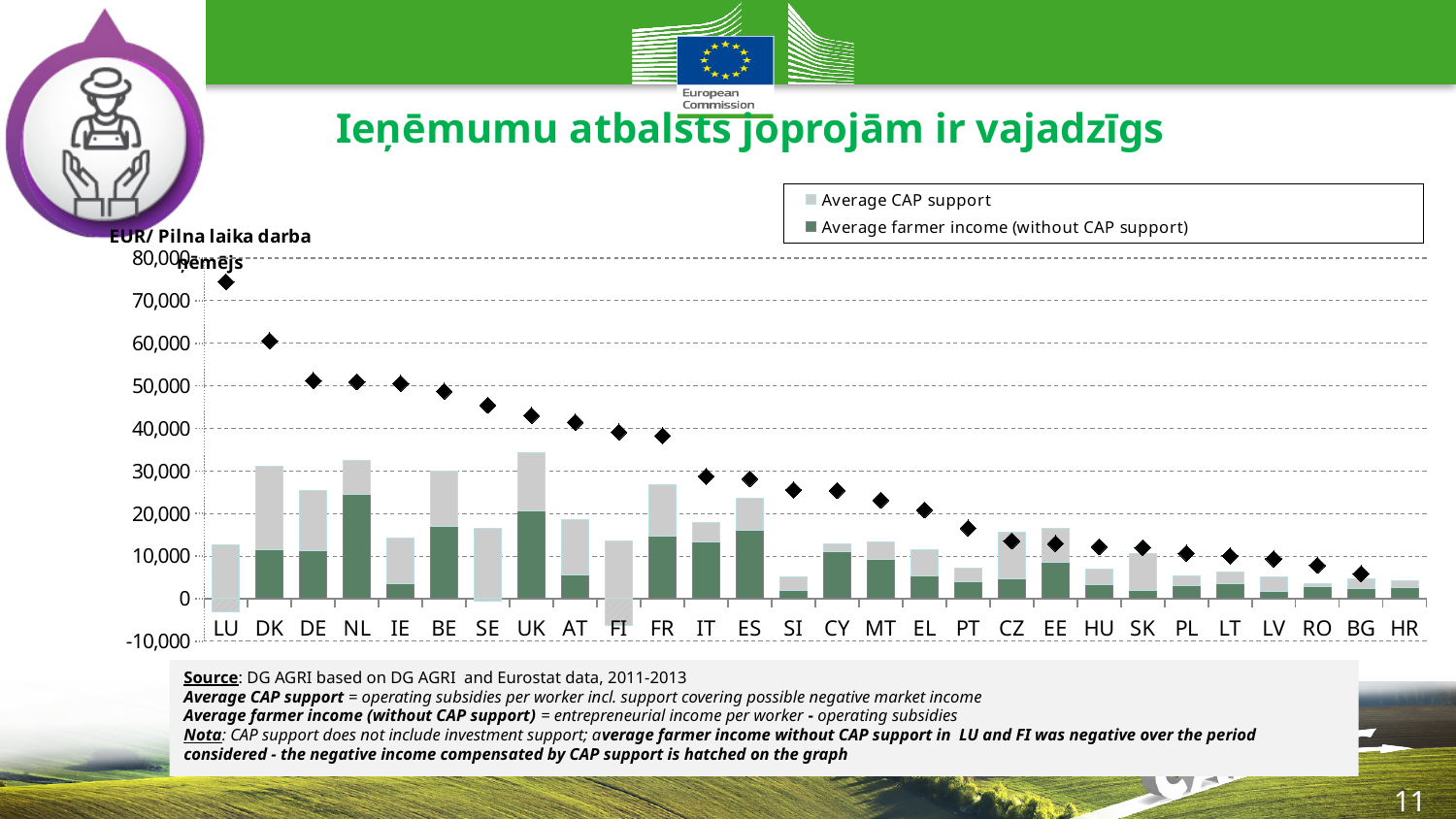
Is the diamond marker for UK greater or less than 40,000? greater How many countries are shown along the x axis of the chart? 28 What kind of chart is shown on the slide? combination chart (stacked bar chart with diamond markers) Is the diamond marker for LU greater or less than 70,000? greater Is the diamond marker for FR greater or less than 40,000? less Do the diamond markers rise or fall moving from left to right along the x axis? fall What is the title of the slide containing the chart? Ieņēmumu atbalsts joprojām ir vajadzīgs Which country has the tallest Average farmer income (without CAP support) bar? NL How many series does the chart legend list? 2 Which country has the highest diamond marker on the chart? LU